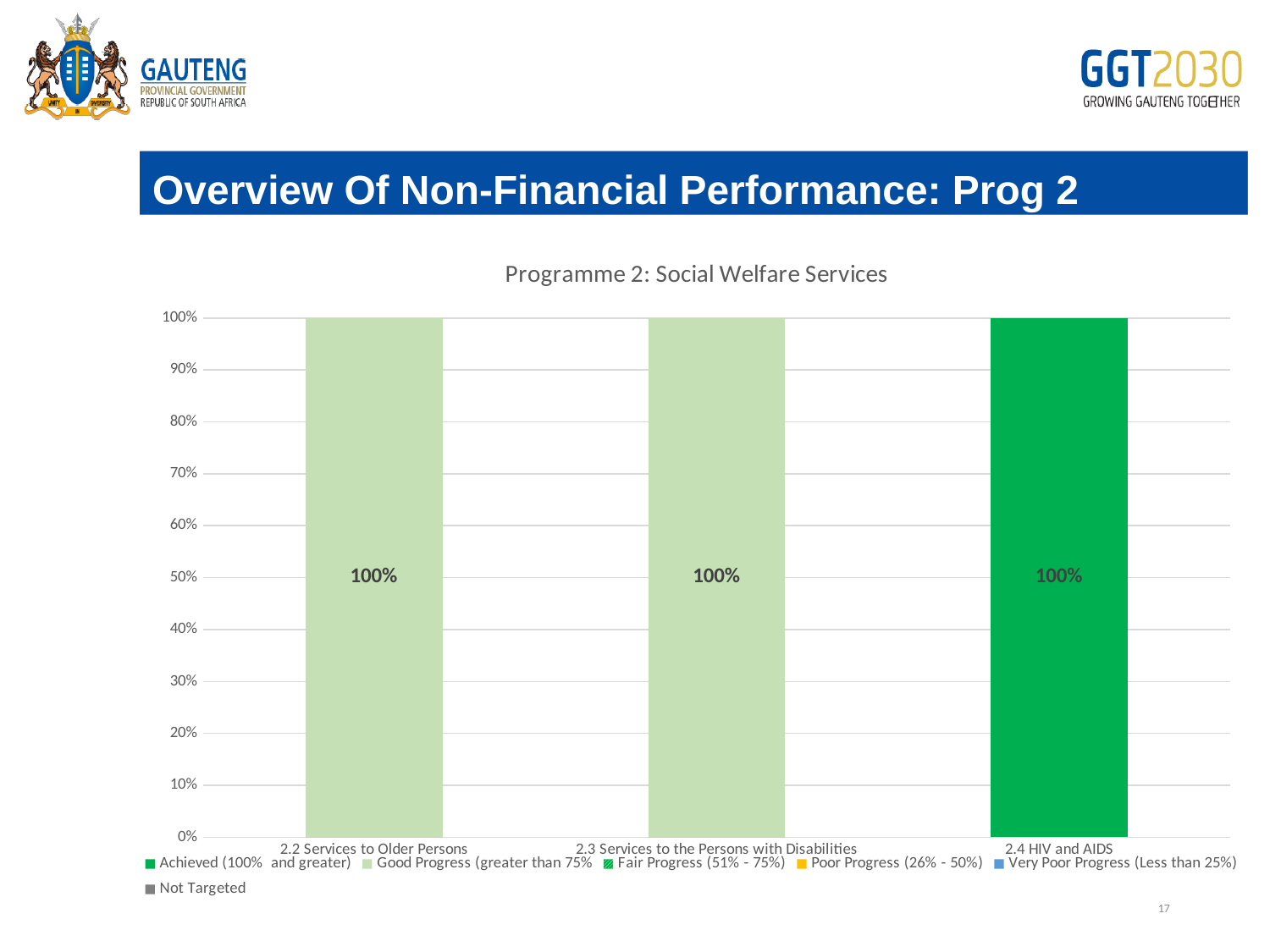
Is the value for 2.2 Services to Older Persons greater or less than 90%? greater What is the value shown for 2.3 Services to the Persons with Disabilities? 100% What is the value shown for 2.2 Services to Older Persons? 100% Which legend series does the bar for 2.4 HIV and AIDS belong to? Achieved (100% and greater) How many categories are plotted on the x axis of the chart? 3 What kind of chart is shown on the slide? Bar chart What is the highest value shown on the y axis of the chart? 100% What is the title of the chart? Programme 2: Social Welfare Services Do the values rise, fall, or stay the same across the three categories from left to right? Stay the same What is the value shown for 2.4 HIV and AIDS? 100% How many series does the chart's legend list? 6 What is the total of the stacked bar for 2.3 Services to the Persons with Disabilities? 100%